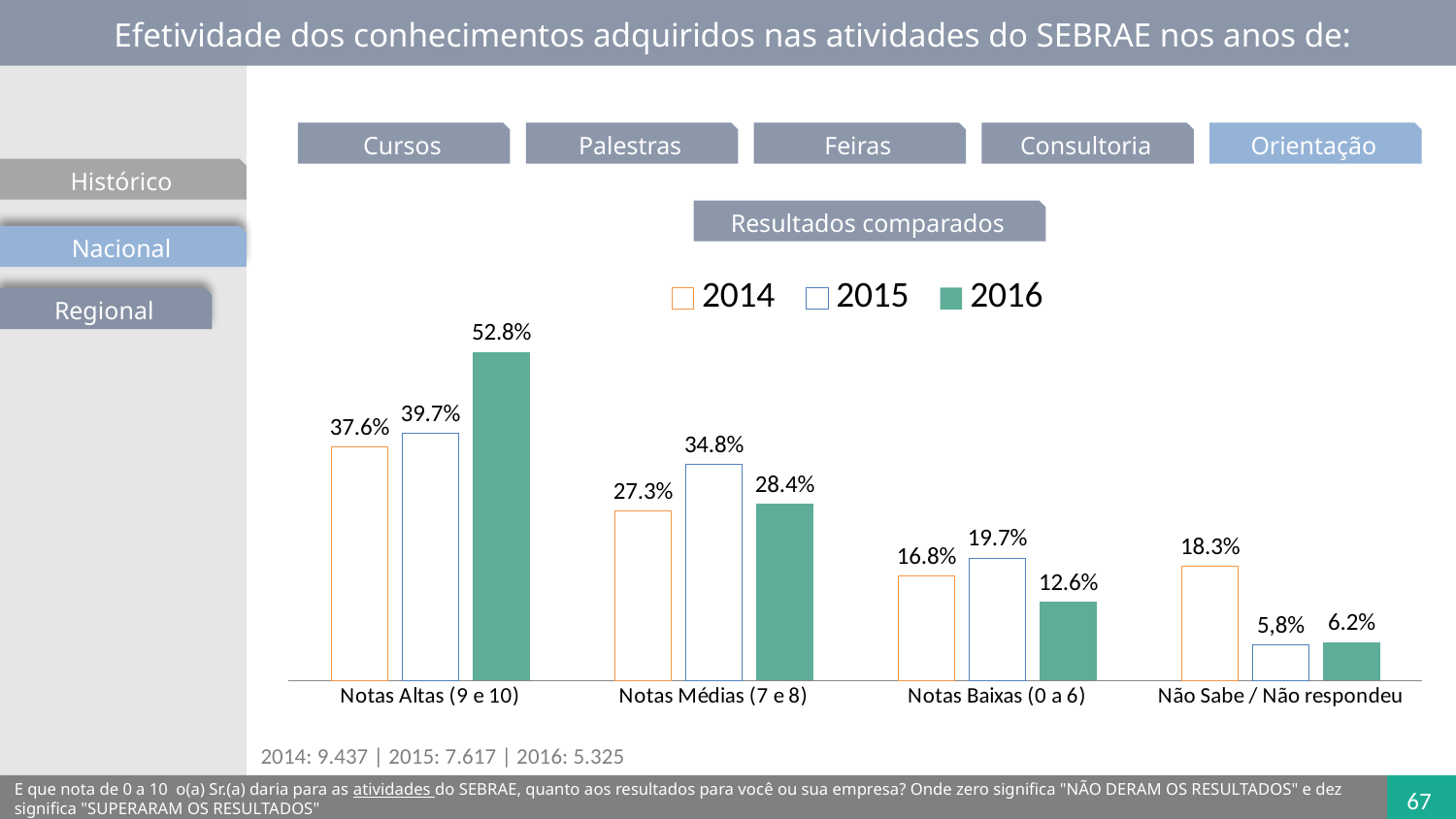
What is the value for 2015 in the Não Sabe / Não respondeu category? 5,8% What is the difference between the 2016 and 2014 values in the Notas Altas (9 e 10) category? 15.2% Which category has the highest value for the 2016 series? Notas Altas (9 e 10) How many categories are shown on the x axis of the chart? 4 What kind of chart is shown on the slide? Bar chart In the Notas Médias (7 e 8) category, which is larger: the 2015 value or the 2016 value? 2015 Which series is shown with solid green bars in the legend? 2016 What is the value for 2016 in the Notas Baixas (0 a 6) category? 12.6% What is the value for 2014 in the Notas Médias (7 e 8) category? 27.3% What is the value for 2016 in the Notas Altas (9 e 10) category? 52.8% Which category has the lowest value for the 2014 series? Notas Baixas (0 a 6) How many series does the legend list? 3